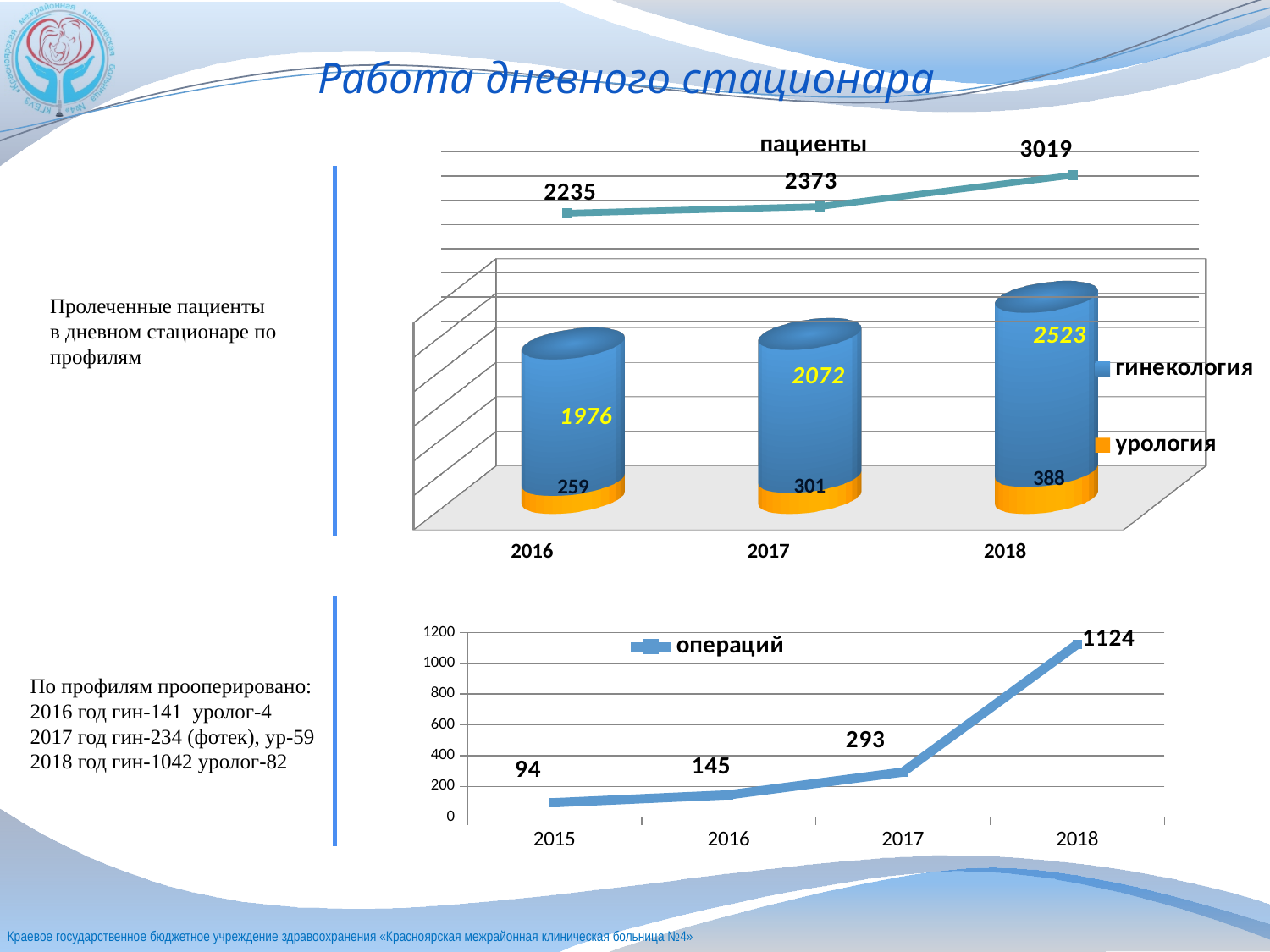
In the "пациенты" line chart at the top, what is the value for 2018? 3019 In the stacked cylinder bar chart in the middle, what is the total of the 2016 bar (гинекология plus урология)? 2235 In the stacked cylinder bar chart in the middle, how many series does the legend list? 2 In the "операций" line chart at the bottom, how many years are plotted on the x axis? 4 In the stacked cylinder bar chart in the middle, which year has the highest value for урология? 2018 In the "операций" line chart at the bottom, which year has the lowest value? 2015 In the "операций" line chart at the bottom, what is the value for 2017? 293 In the stacked cylinder bar chart in the middle, what is the value for урология in 2018? 388 In the stacked cylinder bar chart in the middle, what is the value for гинекология in 2017? 2072 In the "пациенты" line chart at the top, do the values rise or fall from 2016 to 2018? rise In the "пациенты" line chart at the top, by how much did the value increase from 2017 to 2018? 646 In the "пациенты" line chart at the top, what is the value for 2016? 2235